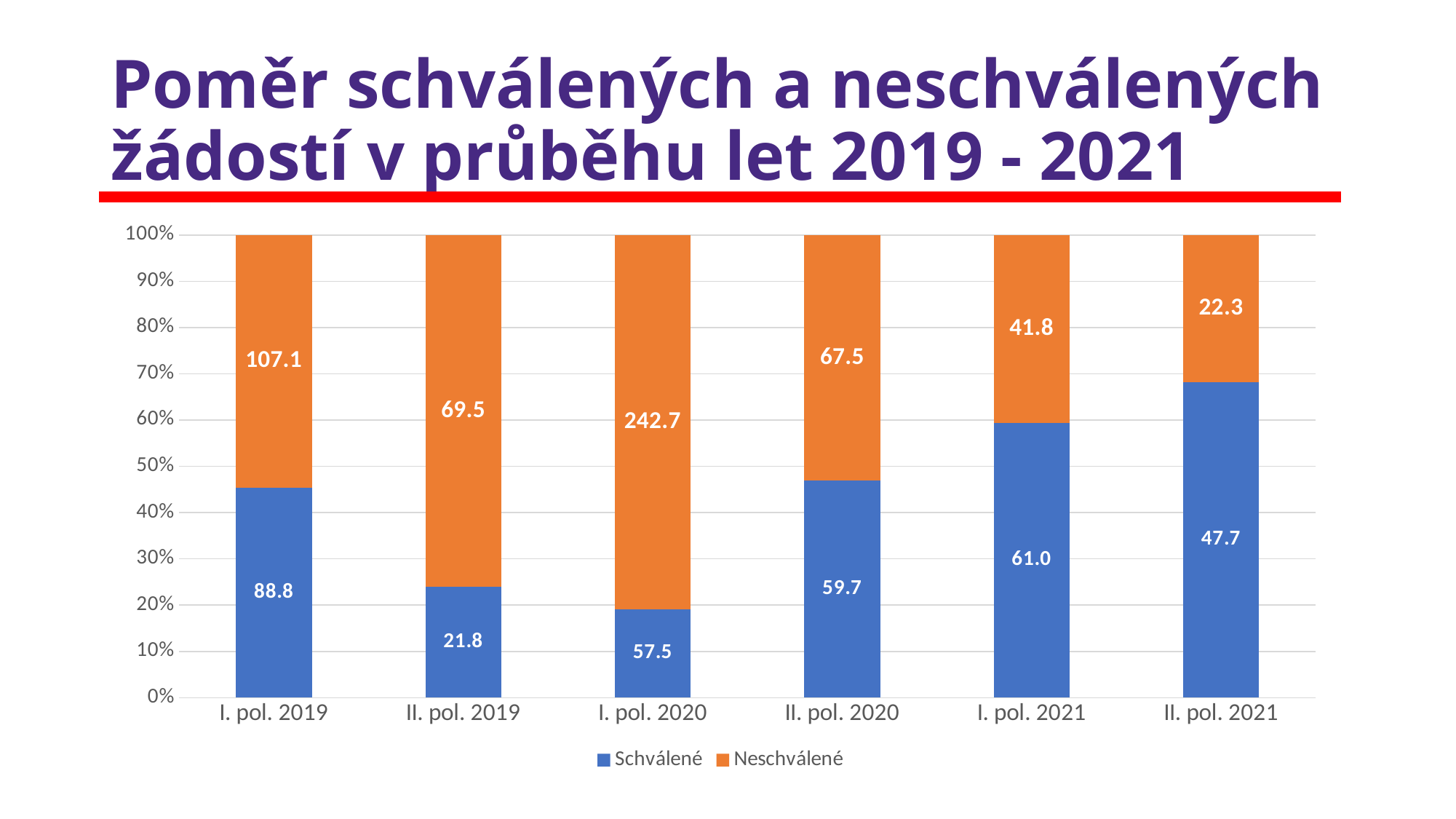
What kind of chart is shown on the slide? stacked bar chart Which period has the highest Neschválené value? I. pol. 2020 What is the difference between the Neschválené and Schválené values for II. pol. 2020? 7.8 What is the Schválené value for I. pol. 2020? 57.5 What is the total of the Schválené and Neschválené values for II. pol. 2019? 91.3 How many series does the legend list? 2 What is the Neschválené value for II. pol. 2021? 22.3 How many periods are shown on the x axis? 6 What is the Neschválené value for I. pol. 2019? 107.1 Which period has the lowest Schválené value? II. pol. 2019 Which is larger for I. pol. 2021, the Schválené value or the Neschválené value? Schválené Is the Schválené share of the I. pol. 2019 bar greater or less than 40%? greater